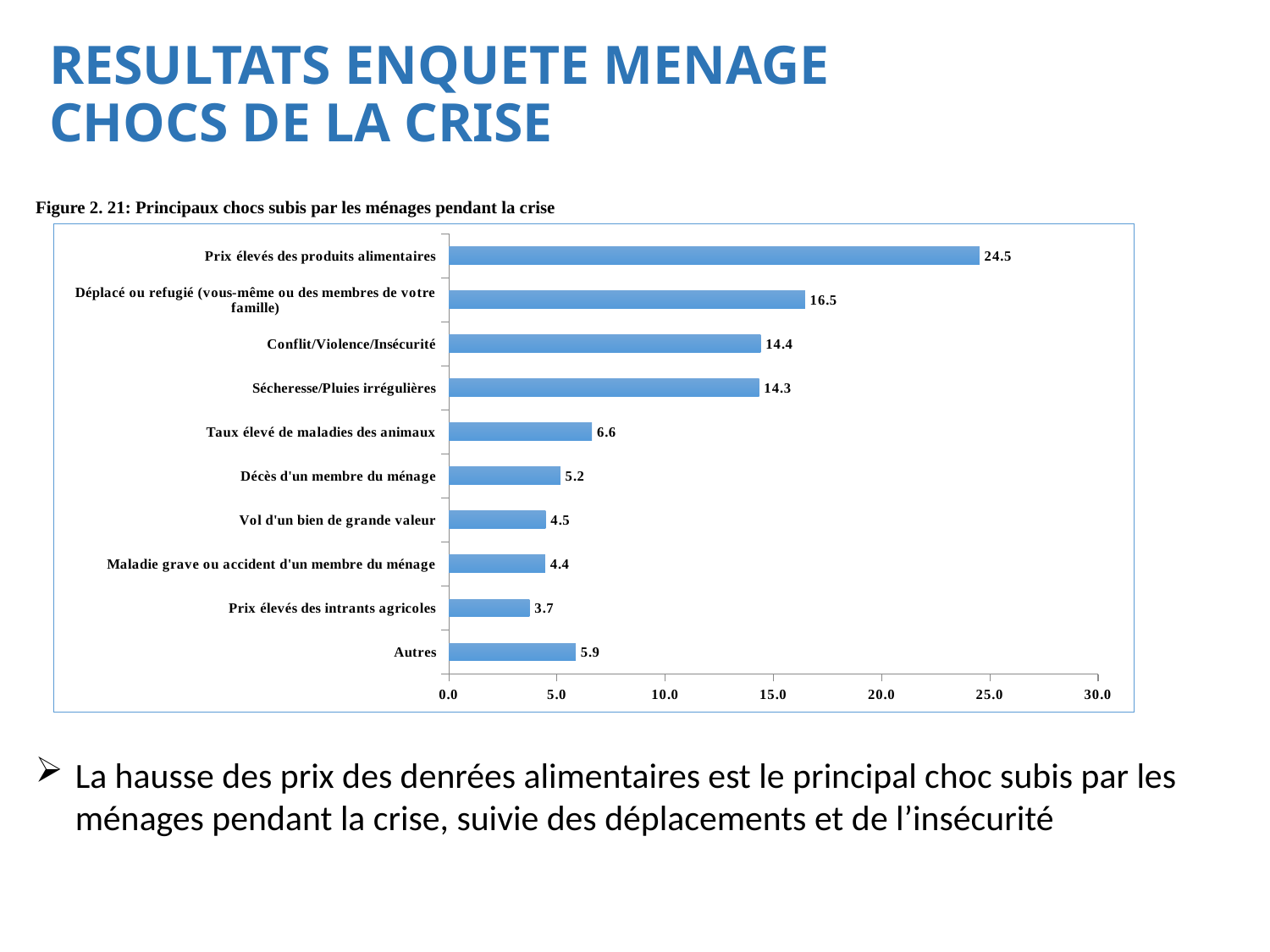
What is the title of the figure shown on the slide? Figure 2. 21: Principaux chocs subis par les ménages pendant la crise Which category has the lowest value? Prix élevés des intrants agricoles Which is larger: the value for "Décès d'un membre du ménage" or the value for "Autres"? Autres What is the difference between the values for "Prix élevés des produits alimentaires" and "Déplacé ou refugié (vous-même ou des membres de votre famille)"? 8.0 What is the value for "Taux élevé de maladies des animaux"? 6.6 What is the value for "Prix élevés des produits alimentaires"? 24.5 What kind of chart is shown on the slide? Bar chart Which category has the highest value? Prix élevés des produits alimentaires What is the maximum value shown on the horizontal axis? 30.0 What is the value for "Autres"? 5.9 Is the value for "Conflit/Violence/Insécurité" greater or less than 10.0? greater How many categories are shown in the chart? 10